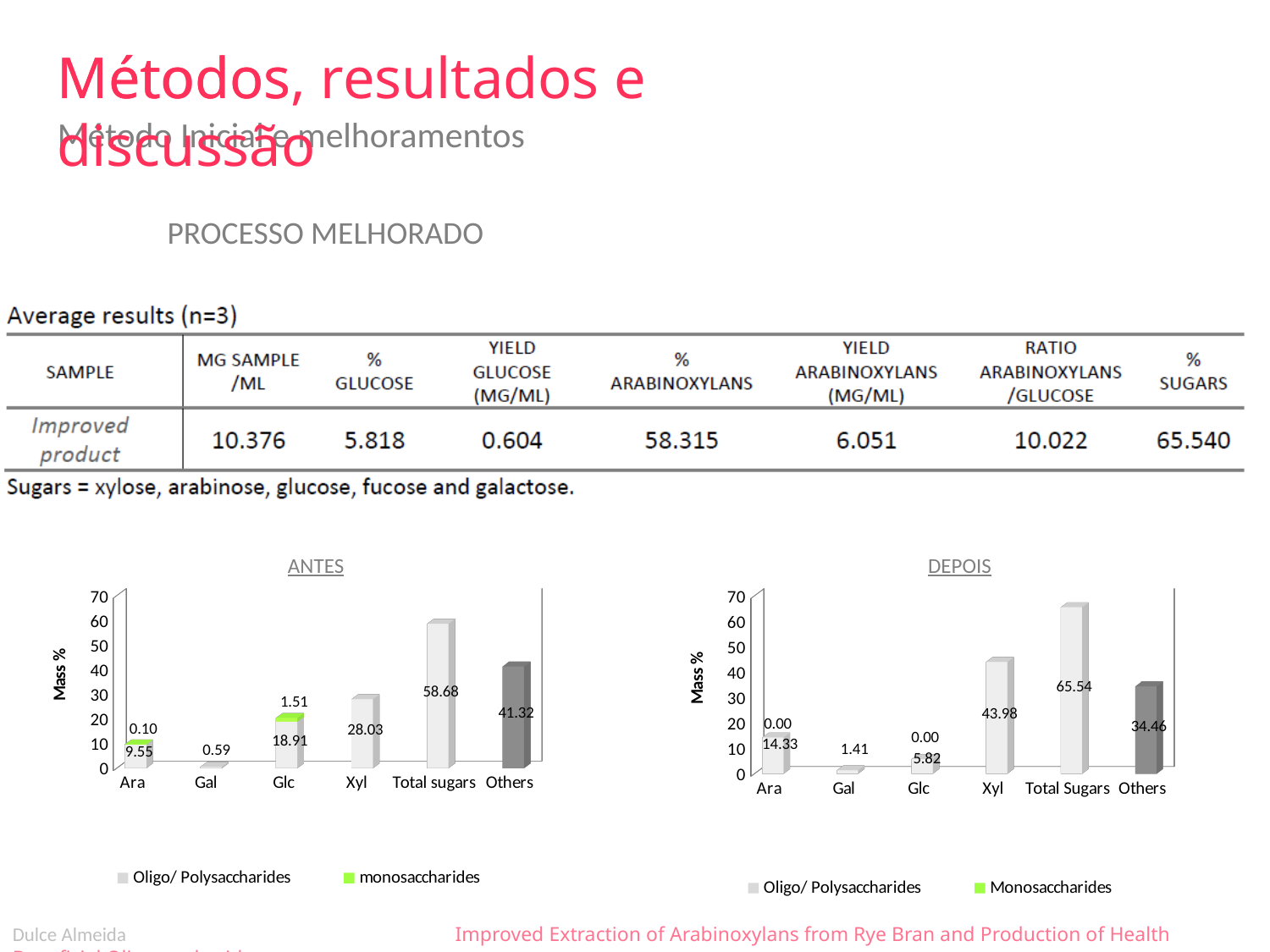
How many series does the legend of the DEPOIS chart list? 2 In the ANTES chart, what is the Oligo/ Polysaccharides value for Xyl? 28.03 In the ANTES chart, which is larger: the Oligo/ Polysaccharides value for Glc or for Xyl? Xyl How many categories are shown on the x axis of the ANTES chart? 6 In the DEPOIS chart, what is the value for Total Sugars? 65.54 In the DEPOIS chart, what is the Oligo/ Polysaccharides value for Ara? 14.33 In the DEPOIS chart, what is the difference between the Xyl value (43.98) and the Others value (34.46)? 9.52 In the DEPOIS chart, is the value for Xyl greater or less than 40? greater In the DEPOIS chart, which category has the lowest Oligo/ Polysaccharides value? Gal In the ANTES chart, what is the monosaccharides value for Glc? 1.51 In the ANTES chart, which category has the highest Oligo/ Polysaccharides value? Total sugars What type of chart is the ANTES chart? Bar chart